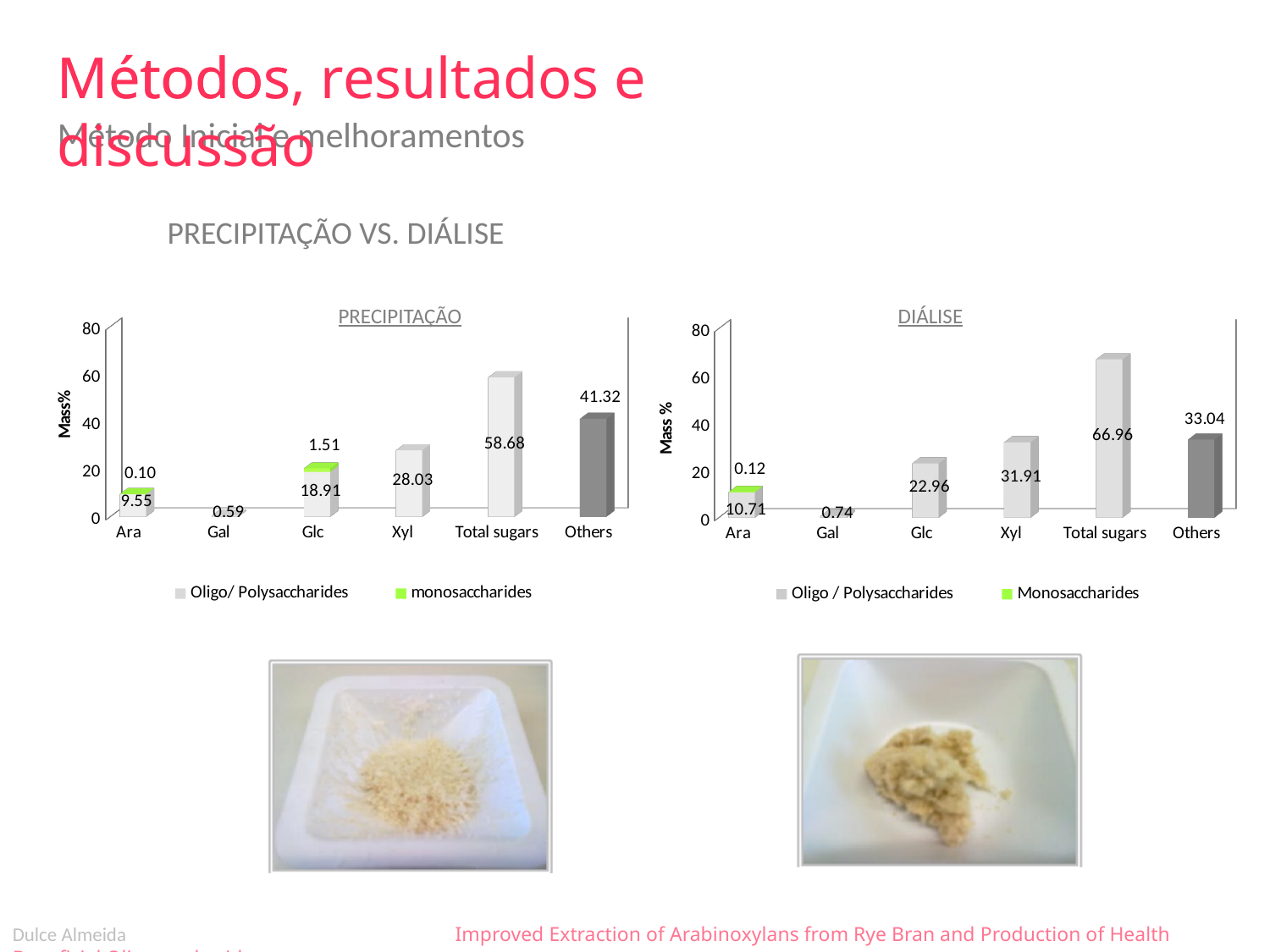
In the PRECIPITAÇÃO chart, which category has the lowest value? Gal In the DIÁLISE chart, what is the Oligo / Polysaccharides value for Ara? 10.71 In the PRECIPITAÇÃO chart, what is the Oligo/Polysaccharides value for Xyl? 28.03 In the PRECIPITAÇÃO chart, what is the monosaccharides value for Glc? 1.51 In the PRECIPITAÇÃO chart, what is the total of the stacked bar for Ara? 9.65 In the DIÁLISE chart, which is larger, the value for Glc or the value for Xyl? Xyl What kind of chart is the DIÁLISE chart? Bar chart In the PRECIPITAÇÃO chart, what is the difference between the Others value and the Xyl value? 13.29 In the DIÁLISE chart, which category has the highest value? Total sugars How many series does the legend of the PRECIPITAÇÃO chart list? 2 How many categories are shown on the x axis of the DIÁLISE chart? 6 In the DIÁLISE chart, what is the value for Total sugars? 66.96